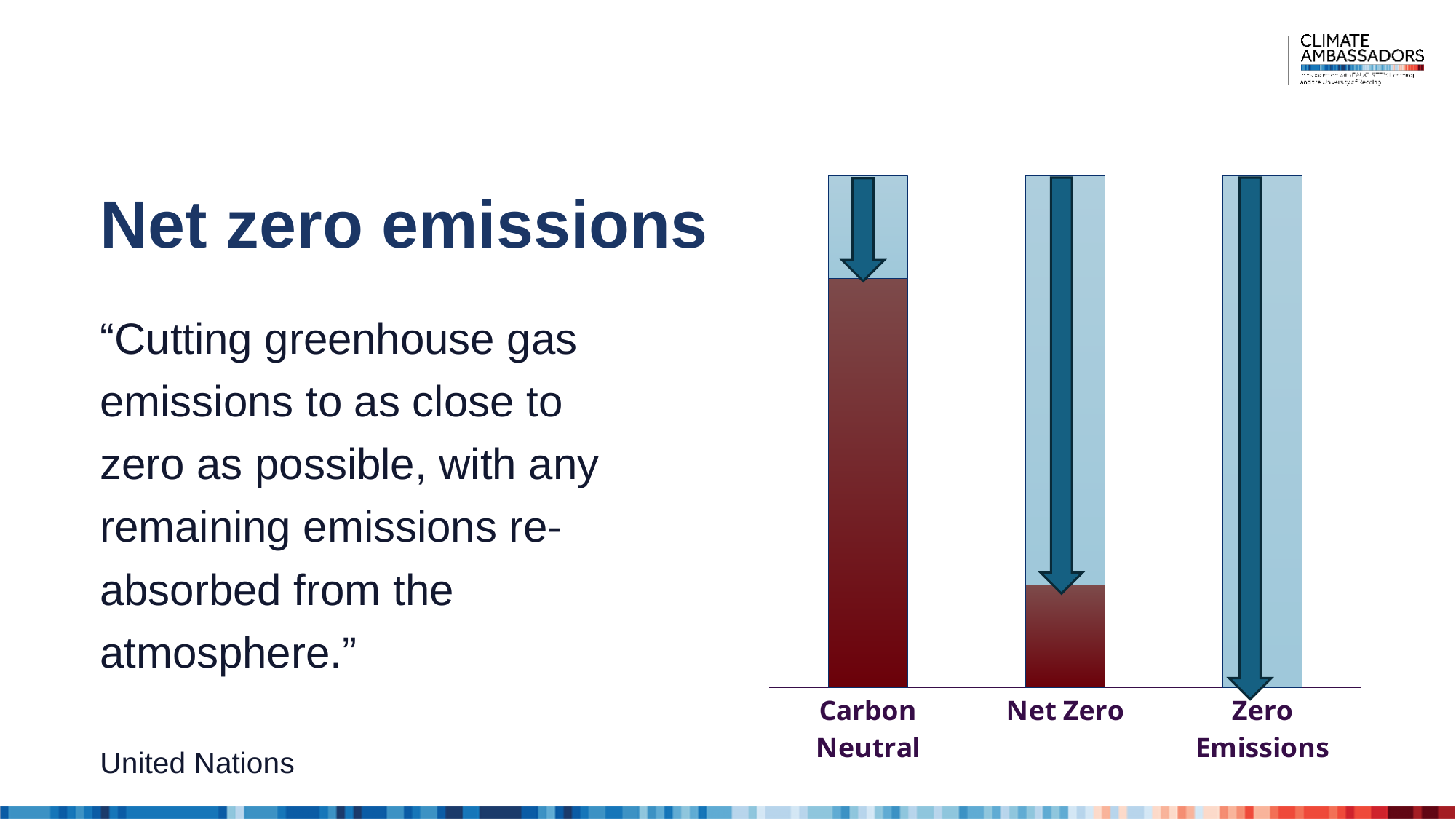
Is the dark red segment taller for Net Zero or for Zero Emissions? Net Zero What kind of chart is shown on the right of the slide? bar chart What is the label of the middle category on the x axis? Net Zero What is the label of the first (leftmost) category on the x axis? Carbon Neutral Which category in the bar chart has the tallest dark red bar segment? Carbon Neutral Does the height of the dark red segment rise or fall from left to right across the categories? fall Is the dark red segment taller for Carbon Neutral or for Net Zero? Carbon Neutral Which category in the bar chart has no dark red segment at all? Zero Emissions How many categories are shown on the x axis of the bar chart? 3 Which category in the bar chart has the smallest dark red bar segment? Zero Emissions